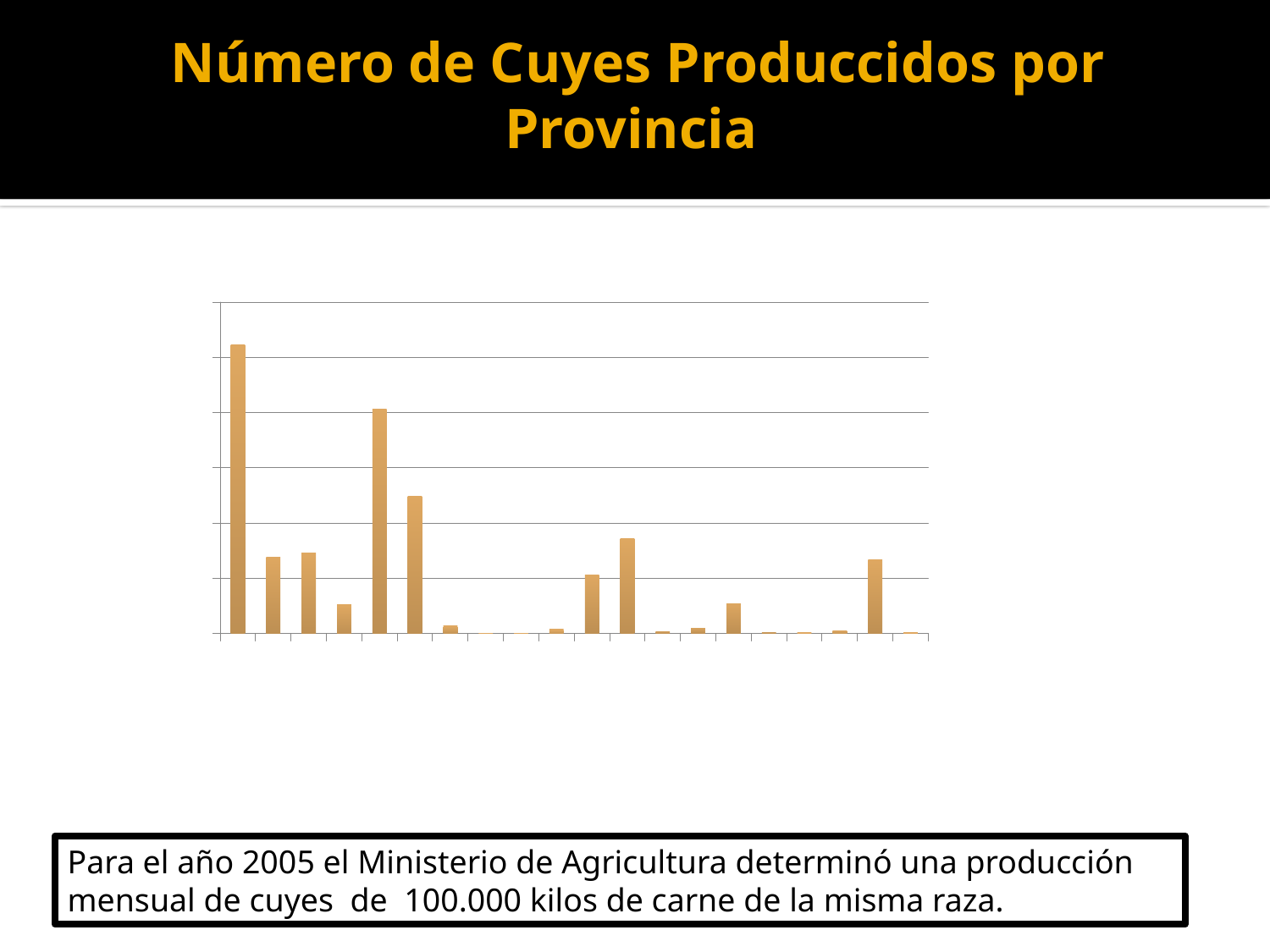
How many bars (categories) are plotted in the chart? 20 What kind of chart is shown on the slide? bar chart What is the title shown above the chart on the slide? Número de Cuyes Produccidos por Provincia Which is taller, the first bar from the left or the fifth bar from the left? the first bar Does the chart display a legend? No Which is taller, the sixth bar from the left or the twelfth bar from the left? the sixth bar Which bar is the tallest in the chart, counting from the left? the first (leftmost) bar